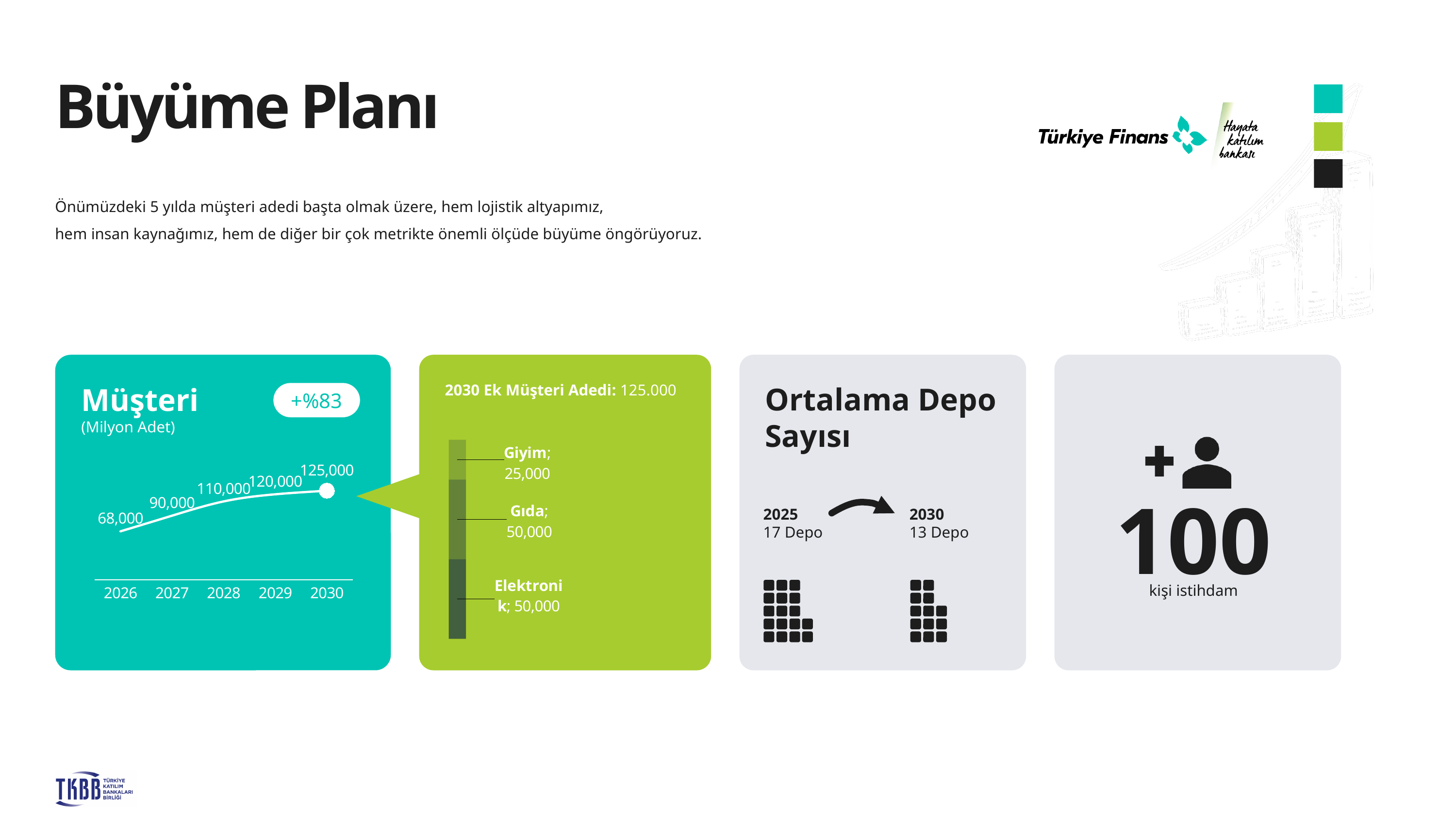
In the stacked bar chart in the green box, what is the total of the three segments? 125,000 In the Müşteri line chart, what is the value for 2028? 110,000 In the Müşteri line chart, which year has the lowest value? 2026 In the Müşteri line chart, what is the value for 2026? 68,000 In the Müşteri line chart, what is the value for 2030? 125,000 In the stacked bar chart in the green box, what is the value for Giyim? 25,000 In the Müşteri line chart, which year has the highest value? 2030 How many years are shown on the x axis of the Müşteri line chart? 5 In the Müşteri line chart, what is the difference between the 2027 and 2026 values? 22,000 In the Müşteri line chart, do the values rise or fall from 2026 to 2030? rise What kind of chart is the Müşteri chart in the teal box? line chart In the stacked bar chart in the green box, which segment is smallest? Giyim